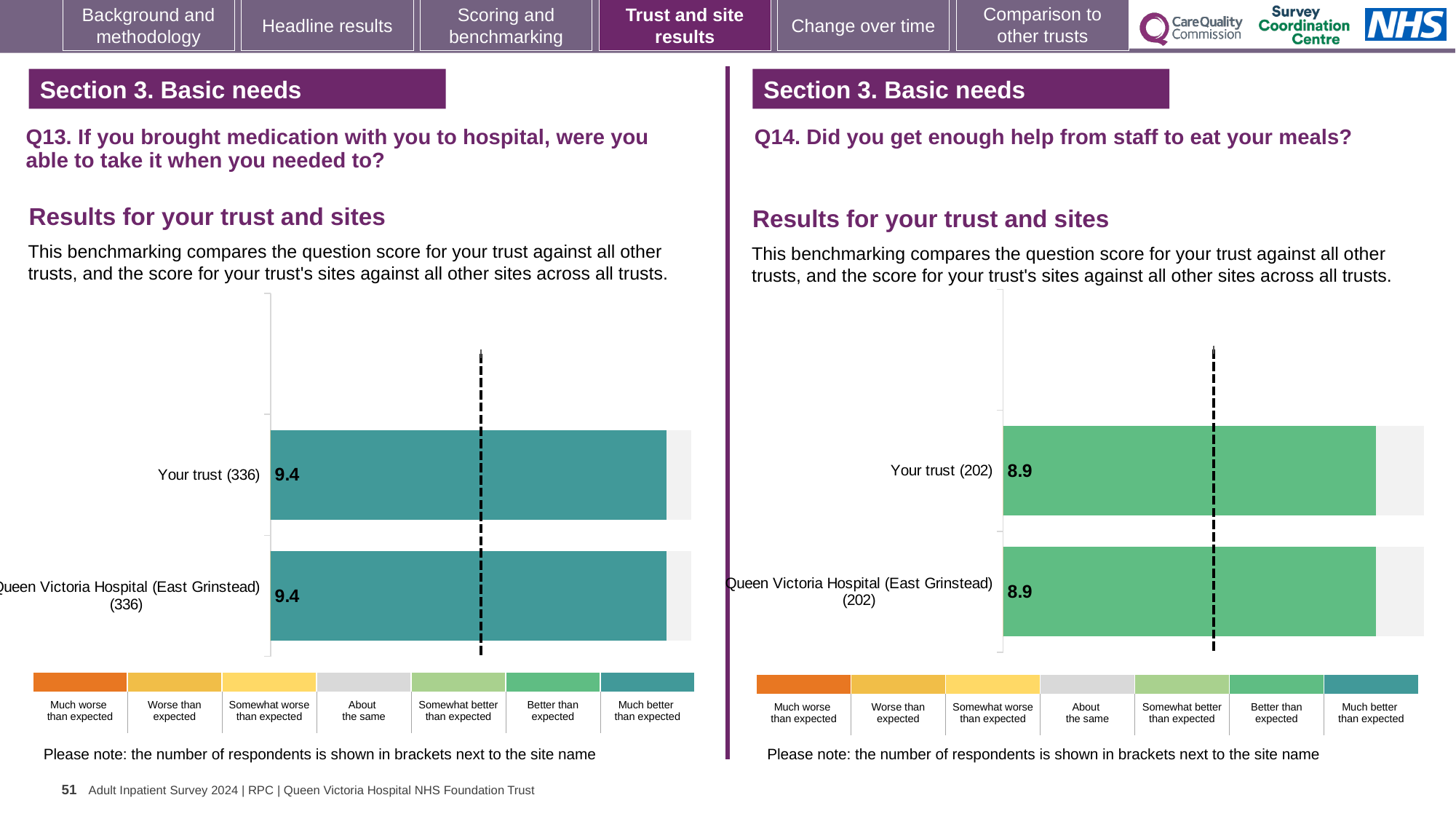
On the Q13 chart (left), what is the difference between the score for Your trust and the score for Queen Victoria Hospital (East Grinstead)? 0 On the Q14 chart (right), what is the score for Your trust? 8.9 On the Q13 chart (left), what is the score for Your trust? 9.4 On the Q13 chart (left), how many respondents are shown in brackets for Your trust? 336 On the Q14 chart (right), which benchmark category does the colour of the bars correspond to according to the legend? Better than expected What kind of chart is used on the Q13 chart (left)? Bar chart On the Q14 chart (right), how many respondents are shown in brackets for Queen Victoria Hospital (East Grinstead)? 202 On the Q13 chart (left), which benchmark category does the colour of the bars correspond to according to the legend? Much better than expected On the Q14 chart (right), how many bars are plotted? 2 On the Q14 chart (right), what is the score for Queen Victoria Hospital (East Grinstead)? 8.9 On the Q13 chart (left), what is the score for Queen Victoria Hospital (East Grinstead)? 9.4 Is the score for Your trust on the Q13 chart (left) larger or smaller than the score for Your trust on the Q14 chart (right)? Larger